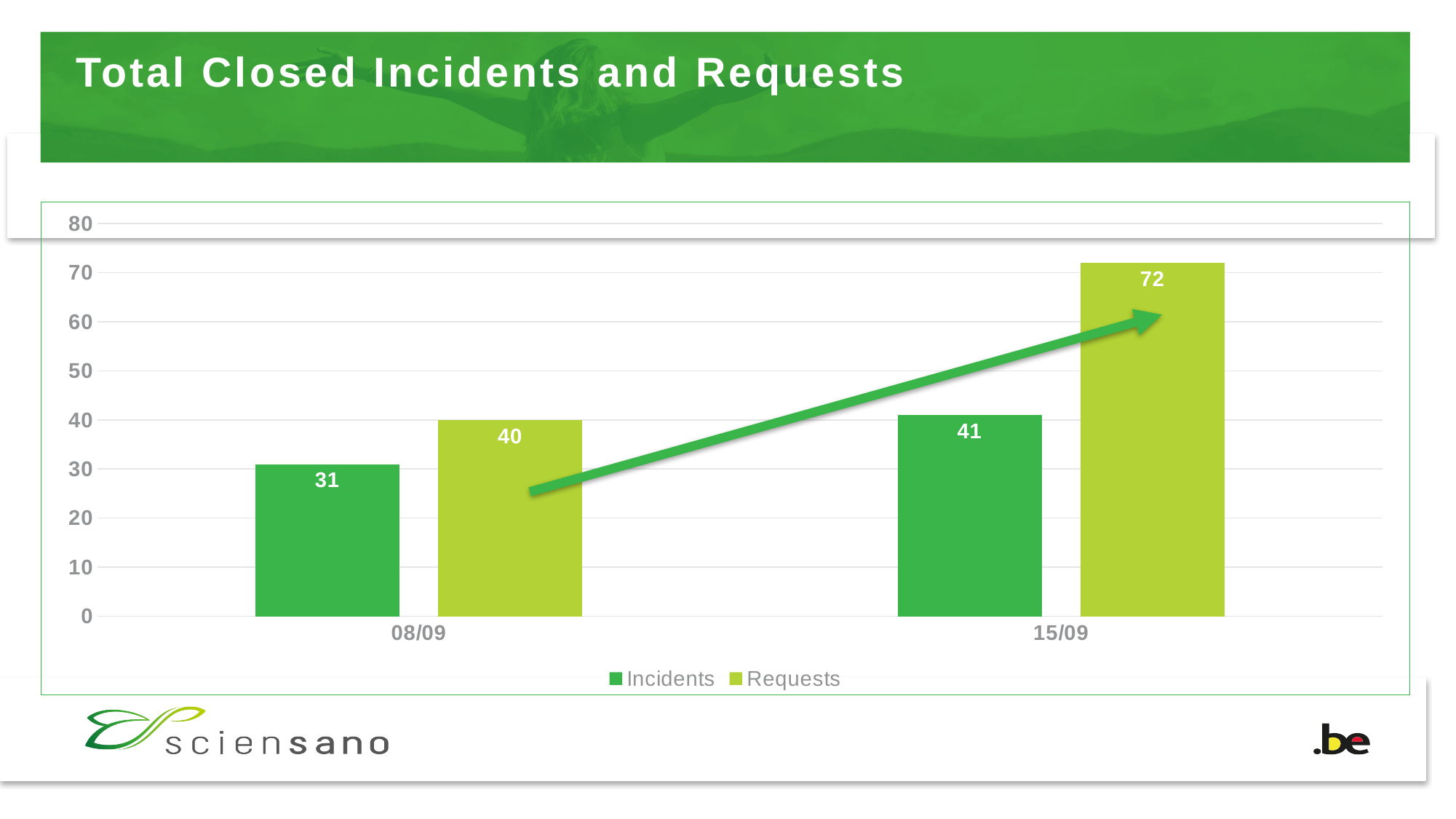
What is the value for Incidents on 15/09? 41 What is the value for Incidents on 08/09? 31 What is the value for Requests on 08/09? 40 Do the Incidents values rise or fall from 08/09 to 15/09? Rise How many series does the legend list? 2 How many dates are shown on the x axis? 2 Which date has the highest Requests value? 15/09 Which date has the lowest Incidents value? 08/09 What is the difference between Requests on 15/09 and Requests on 08/09? 32 Which is larger on 15/09: Incidents or Requests? Requests What kind of chart is shown? Bar chart What is the value for Requests on 15/09? 72